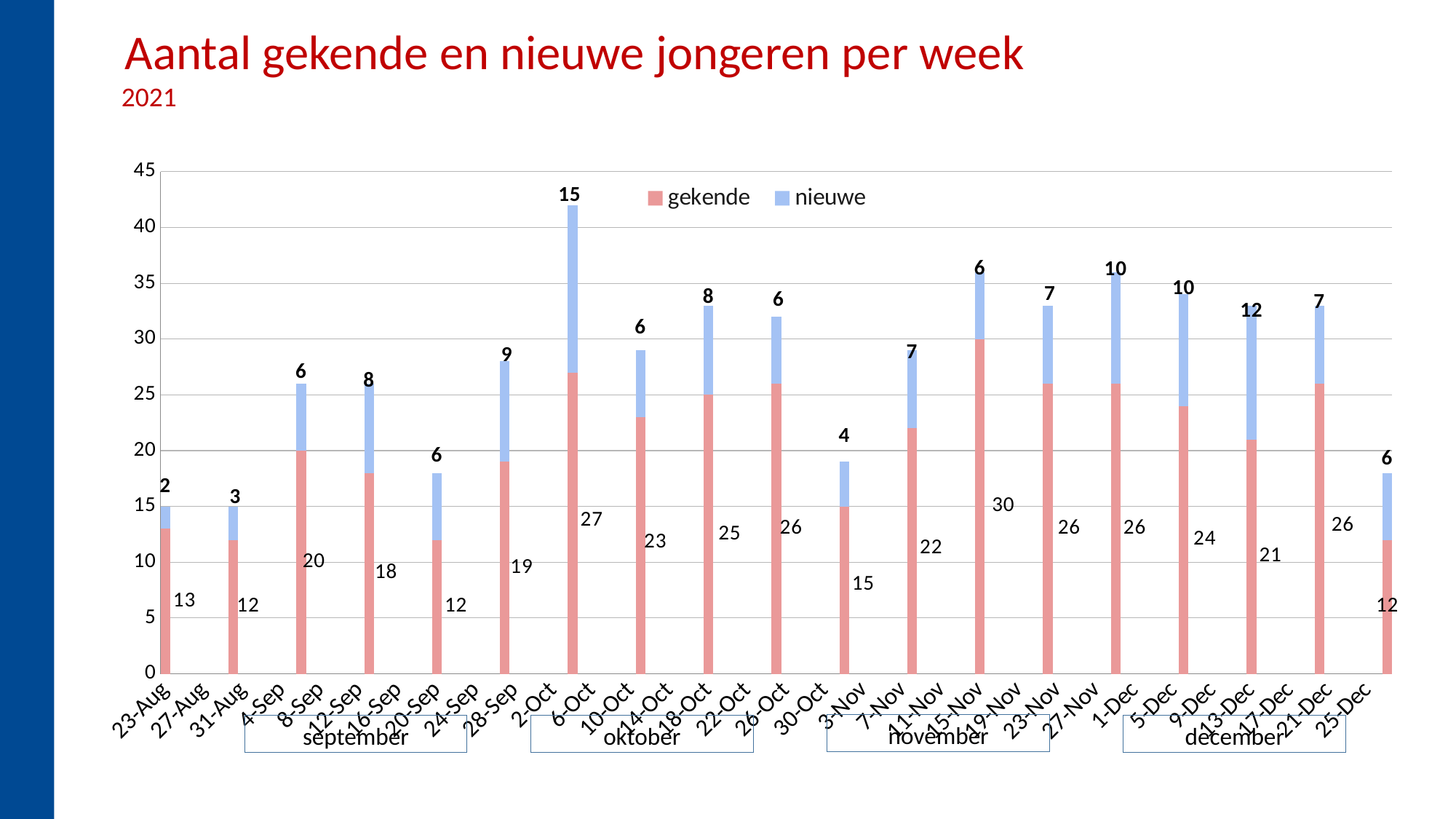
What is the title of the chart? Aantal gekende en nieuwe jongeren per week What is the total of the tallest bar (gekende 27 plus nieuwe 15)? 42 What is the highest 'nieuwe' value labelled on any bar? 15 What is the 'gekende' value for the first bar (23-Aug)? 13 What are the two series named in the legend? gekende and nieuwe What kind of chart is shown on the slide? stacked bar chart What is the highest 'gekende' value labelled on any bar? 30 Is the total of the tallest bar greater or less than 40? greater How many series does the legend list? 2 What is the difference between the highest 'gekende' value (30) and the highest 'nieuwe' value (15)? 15 How many bars are plotted in the chart? 19 What is the lowest 'nieuwe' value labelled on any bar? 2